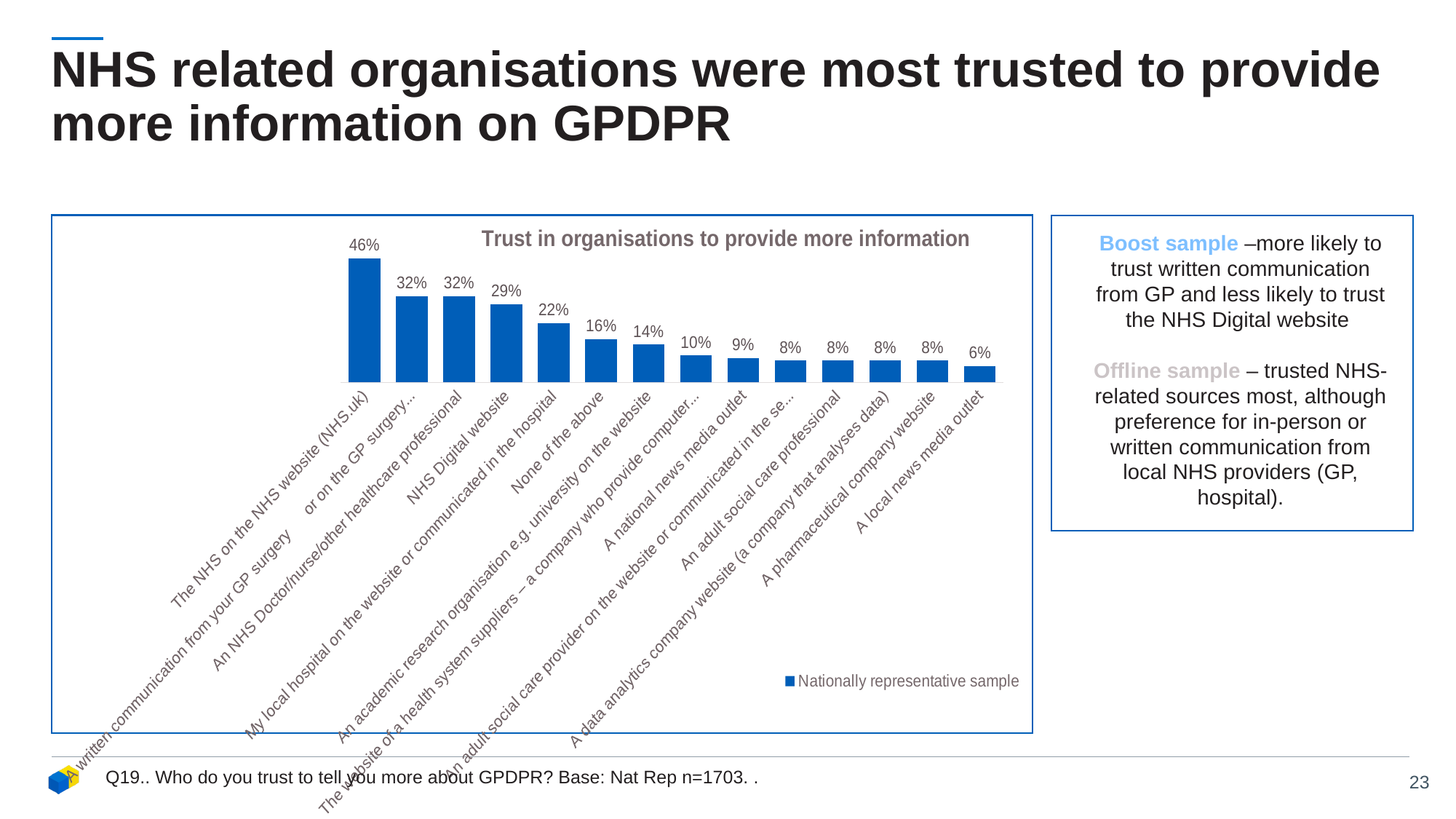
Which is larger: the value for 'An academic research organisation e.g. university on the website' or the value for 'A pharmaceutical company website'? An academic research organisation e.g. university on the website What is the value for 'NHS Digital website'? 29% What is the title of the chart? Trust in organisations to provide more information What is the value for 'A national news media outlet'? 9% Which category has the lowest value in the chart? A local news media outlet How many bars are shown in the chart? 14 What is the difference between the values for 'The NHS on the NHS website (NHS.uk)' and 'NHS Digital website'? 17% How many series does the legend list? 1 What is the value for 'None of the above'? 16% What type of chart is shown on the slide? Bar chart What is the value for 'The NHS on the NHS website (NHS.uk)' in the chart? 46% Which category has the highest value in the chart? The NHS on the NHS website (NHS.uk)